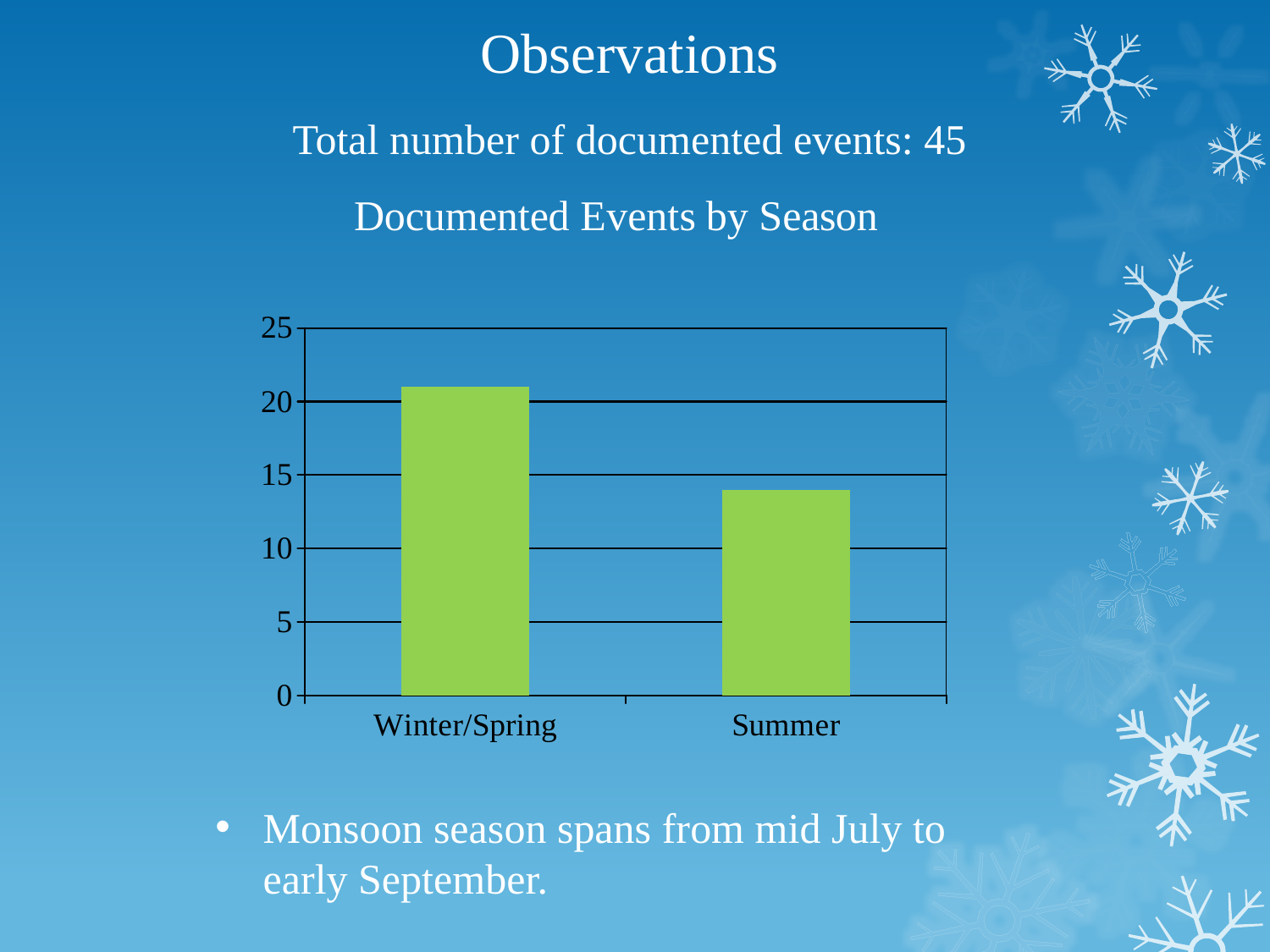
What kind of chart is shown on the slide? bar chart Is the value for Winter/Spring greater or less than 15? greater What is the highest value shown on the chart's vertical axis? 25 Which is larger, the value for Winter/Spring or the value for Summer? Winter/Spring Which season has the highest number of documented events in the chart? Winter/Spring Which season has the lowest number of documented events in the chart? Summer Is the value for Summer greater or less than 20? less What is the title of the chart? Documented Events by Season How many categories are shown on the x axis of the chart? 2 Is the value for Summer greater or less than 10? greater